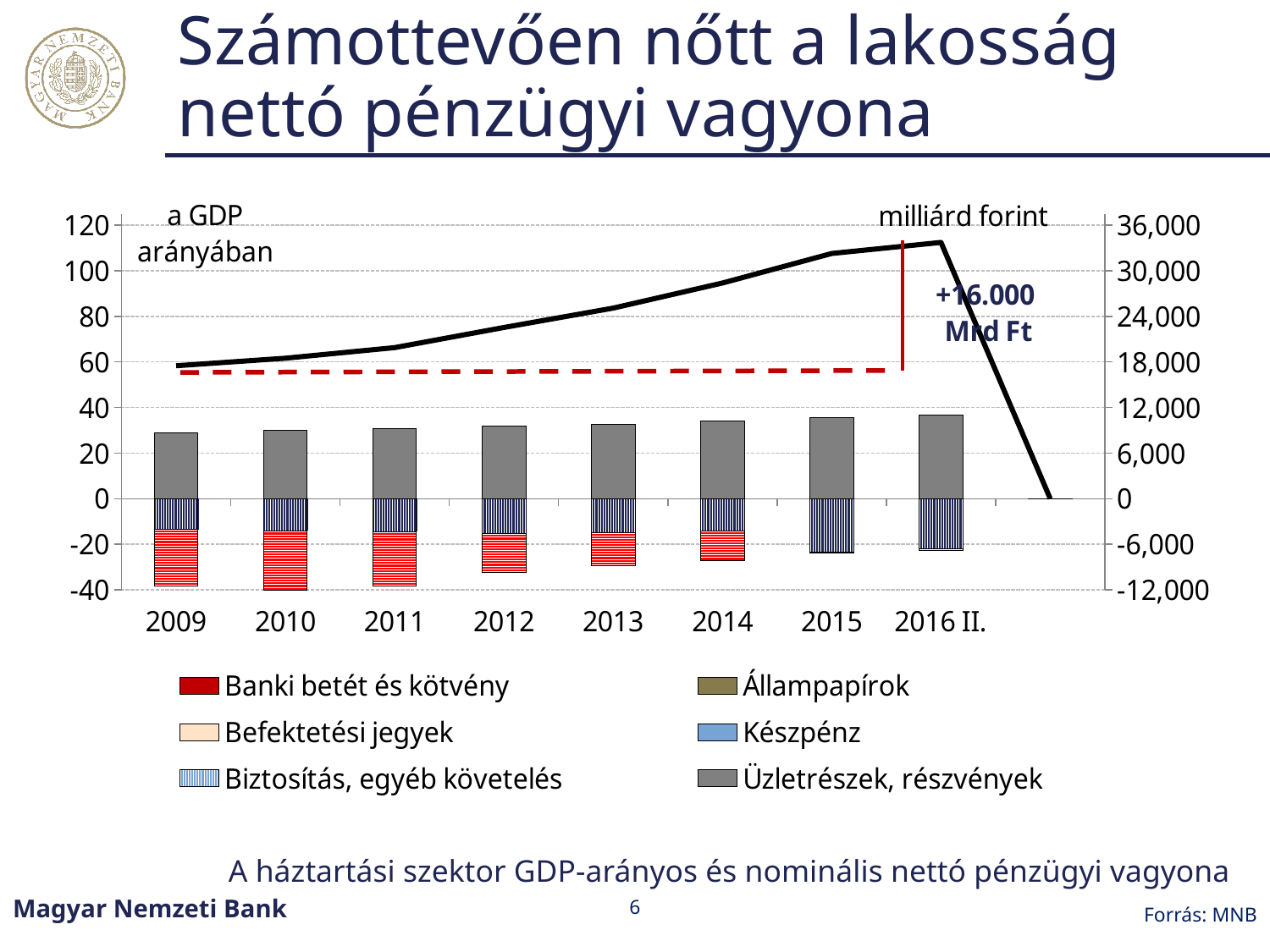
Is the grey 'Üzletrészek, részvények' bar for 2009 greater or less than 40 on the left axis? less Which is larger, the grey 'Üzletrészek, részvények' bar for 2015 or for 2009? 2015 In which period is the grey 'Üzletrészek, részvények' bar the tallest? 2016 II. Does the black line rise or fall from 2009 to 2016 II.? Rises What kind of chart is shown on the slide? A combined bar and line chart What is the source given for the chart? MNB What is the last category label on the x axis of the chart? 2016 II. Is the black line value for 2009 greater or less than 24,000 on the right axis? less Is the grey 'Üzletrészek, részvények' bar for 2016 II. greater or less than 20 on the left axis? greater How many series does the chart's legend list? 6 What increase in Mrd Ft is annotated on the chart? +16.000 Mrd Ft How many time periods are shown on the x axis of the chart? 8